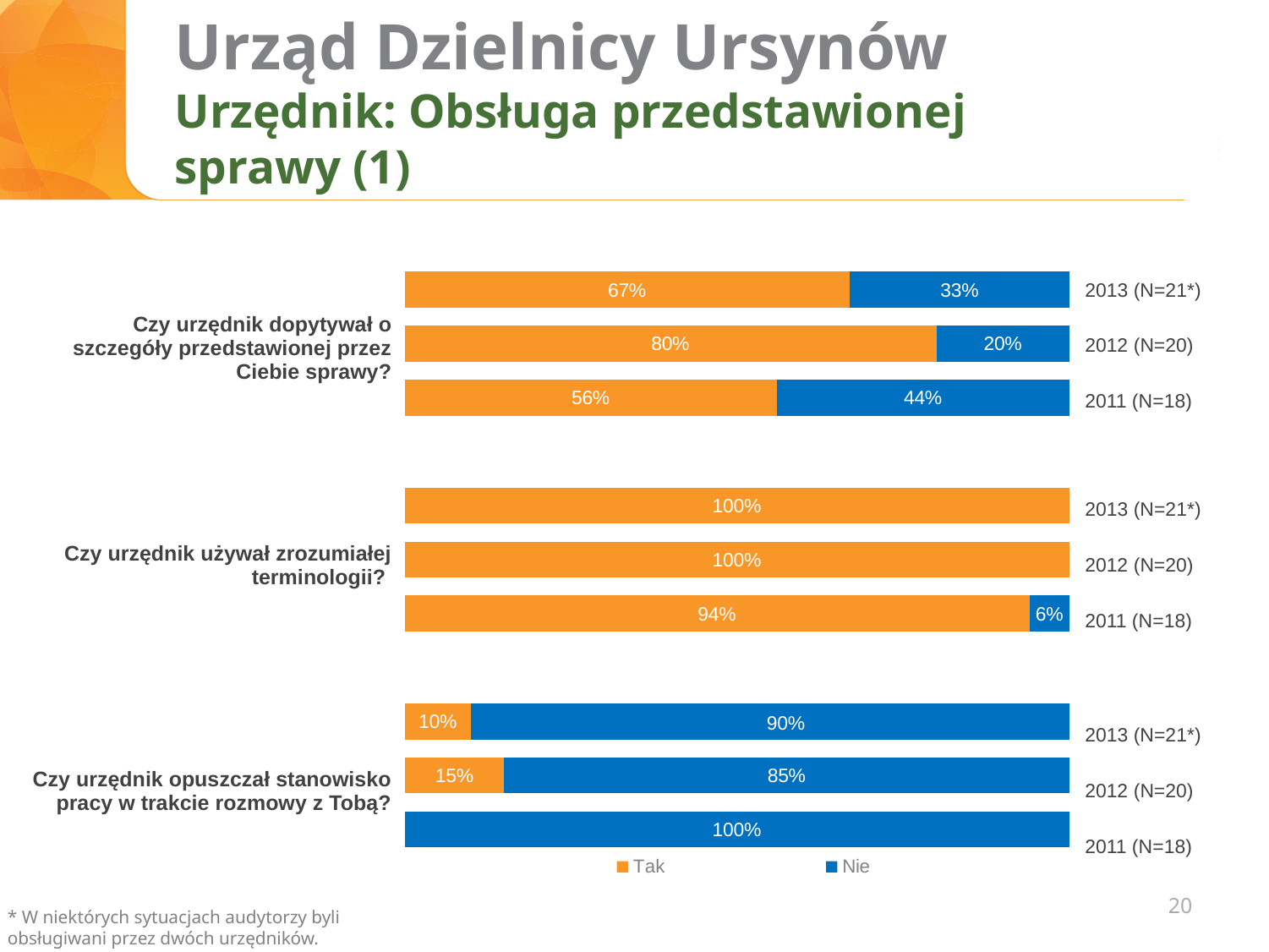
For the question 'Czy urzędnik opuszczał stanowisko pracy w trakcie rozmowy z Tobą?', which year has the lowest 'Nie' value? 2012 (N=20) For the question 'Czy urzędnik opuszczał stanowisko pracy w trakcie rozmowy z Tobą?', is the 'Nie' value for 2013 (N=21*) larger or smaller than the 'Nie' value for 2012 (N=20)? larger What type of chart is shown on the slide? stacked bar chart What is the 'Tak' value for 2012 (N=20) for the question 'Czy urzędnik opuszczał stanowisko pracy w trakcie rozmowy z Tobą?' 15% What are the two series named in the legend? Tak and Nie For the question 'Czy urzędnik dopytywał o szczegóły przedstawionej przez Ciebie sprawy?', which year has the highest 'Tak' value? 2012 (N=20) What is the 'Nie' value for 2011 (N=18) for the question 'Czy urzędnik dopytywał o szczegóły przedstawionej przez Ciebie sprawy?' 44% How many years are shown for each question in the chart? 3 How many series does the legend list? 2 What is the 'Nie' value for 2011 (N=18) for the question 'Czy urzędnik używał zrozumiałej terminologii?' 6% What is the 'Tak' value for 2013 (N=21*) for the question 'Czy urzędnik dopytywał o szczegóły przedstawionej przez Ciebie sprawy?' 67% What is the difference between the 'Tak' values for 2012 (N=20) and 2011 (N=18) for the question 'Czy urzędnik dopytywał o szczegóły przedstawionej przez Ciebie sprawy?' 24 percentage points